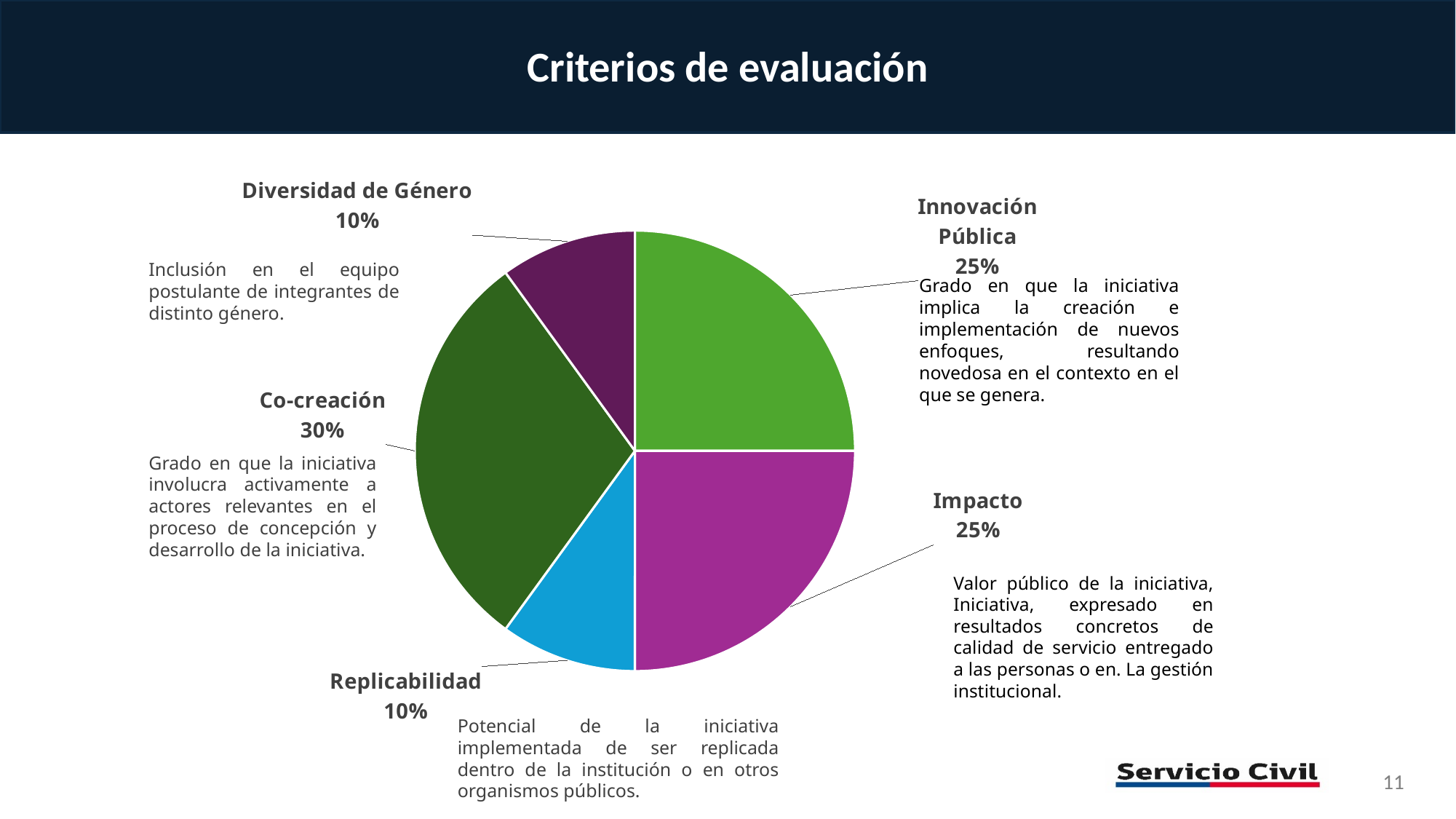
What is the difference between the shares of Co-creación and Impacto? 5% What colour is the Replicabilidad slice? light blue What is the title of the slide containing the pie chart? Criterios de evaluación What share of the pie does Innovación Pública have? 25% What share of the pie does Diversidad de Género have? 10% What is the combined share of Innovación Pública and Impacto? 50% What kind of chart is shown on the slide? pie chart Which is larger, the share for Innovación Pública or the share for Replicabilidad? Innovación Pública Which criterion has the largest slice of the pie? Co-creación How many slices does the pie chart have? 5 What share of the pie does Co-creación have? 30%